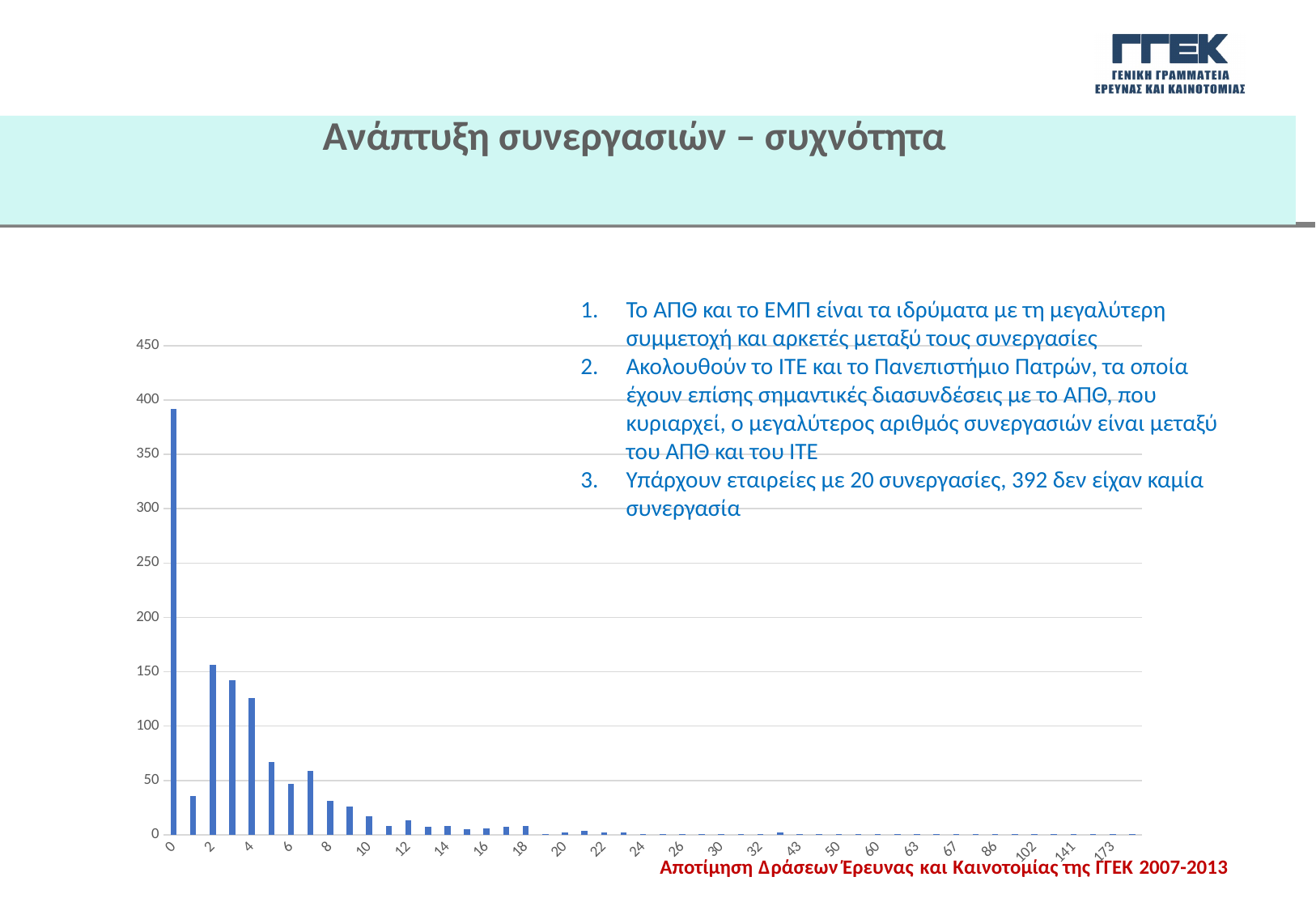
Which has the larger value, category 2 or category 4? 2 Which category on the x axis has the highest bar? 0 Which has the larger value, category 0 or category 2? 0 What kind of chart is shown on the slide? bar chart What is the highest value shown on the y axis of the chart? 450 Is the value for category 8 greater or less than 50? less What is the title of the slide containing the chart? Ανάπτυξη συνεργασιών – συχνότητα Do the bar values generally rise or fall as you move from left to right along the x axis? fall Is the value for category 4 greater or less than 100? greater Is the value for category 2 greater or less than 100? greater